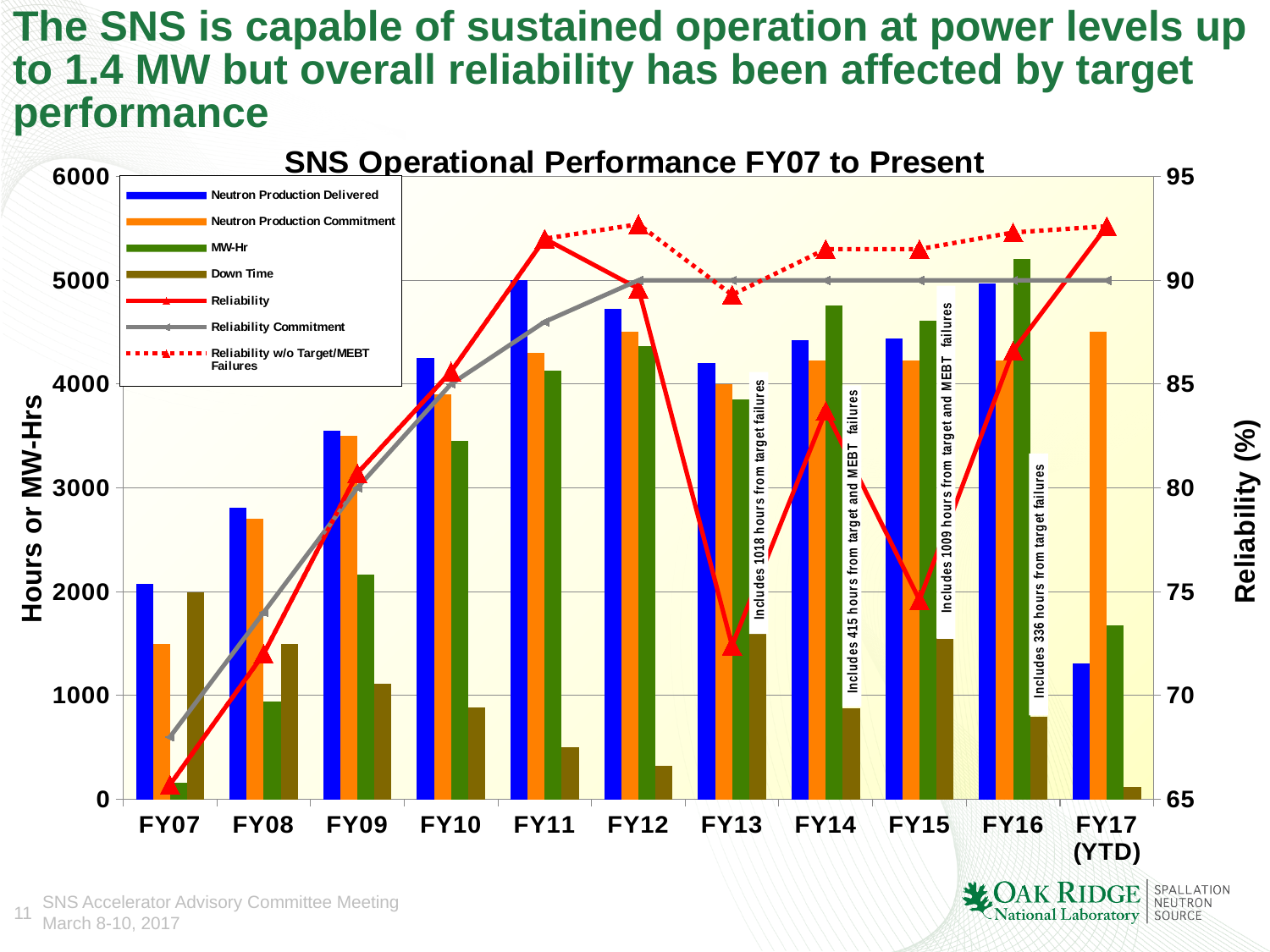
What is the title of the chart? SNS Operational Performance FY07 to Present In FY17 (YTD), which is larger: Neutron Production Delivered or Neutron Production Commitment? Neutron Production Commitment Is the Neutron Production Delivered value for FY08 greater or less than 3000? less Which fiscal year has the lowest Down Time? FY17 (YTD) What is the Reliability Commitment value for FY14? 90 What kind of chart is this? Combination bar and line chart What is the label of the right-hand vertical axis? Reliability (%) How many fiscal-year categories are shown on the x axis? 11 Which fiscal year has the highest Down Time? FY07 Which fiscal year has the highest MW-Hr value? FY16 Is the Reliability value for FY07 greater or less than 70? less How many series does the chart legend list? 7